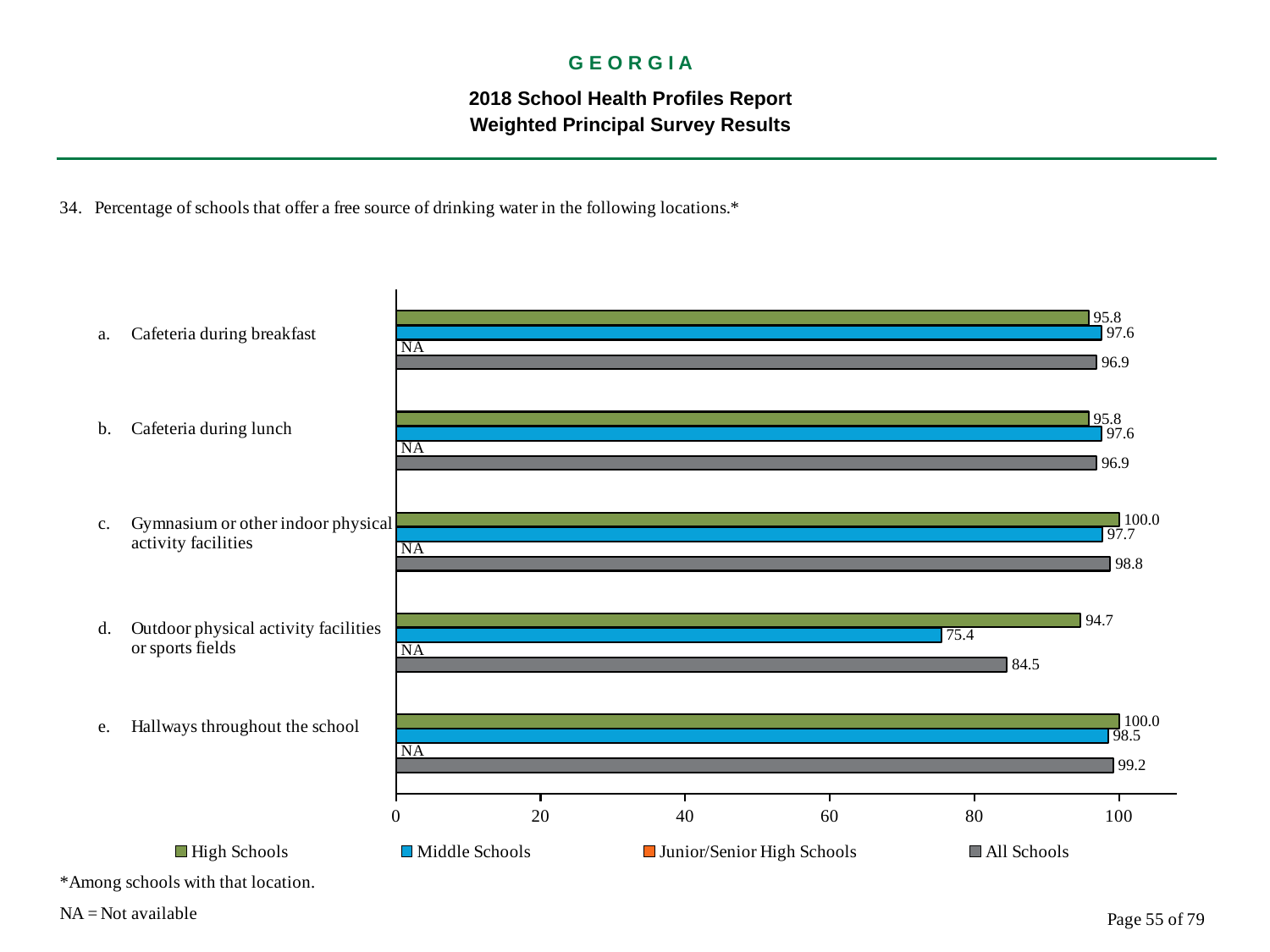
What kind of chart is shown on the slide? bar chart What is the value for High Schools for 'Cafeteria during breakfast'? 95.8 Is the Middle Schools value for 'Outdoor physical activity facilities or sports fields' greater or less than 80? less What is the difference between the High Schools and Middle Schools values for 'Outdoor physical activity facilities or sports fields'? 19.3 How many locations (categories) are shown in the chart? 5 How many series does the legend list? 4 What is the value for Middle Schools for 'Outdoor physical activity facilities or sports fields'? 75.4 What value is shown for Junior/Senior High Schools in every category? NA For 'Hallways throughout the school', which is larger: the High Schools value or the Middle Schools value? High Schools Which location has the lowest value for All Schools? Outdoor physical activity facilities or sports fields What is the value for All Schools for 'Gymnasium or other indoor physical activity facilities'? 98.8 Which location has the lowest value for Middle Schools? Outdoor physical activity facilities or sports fields